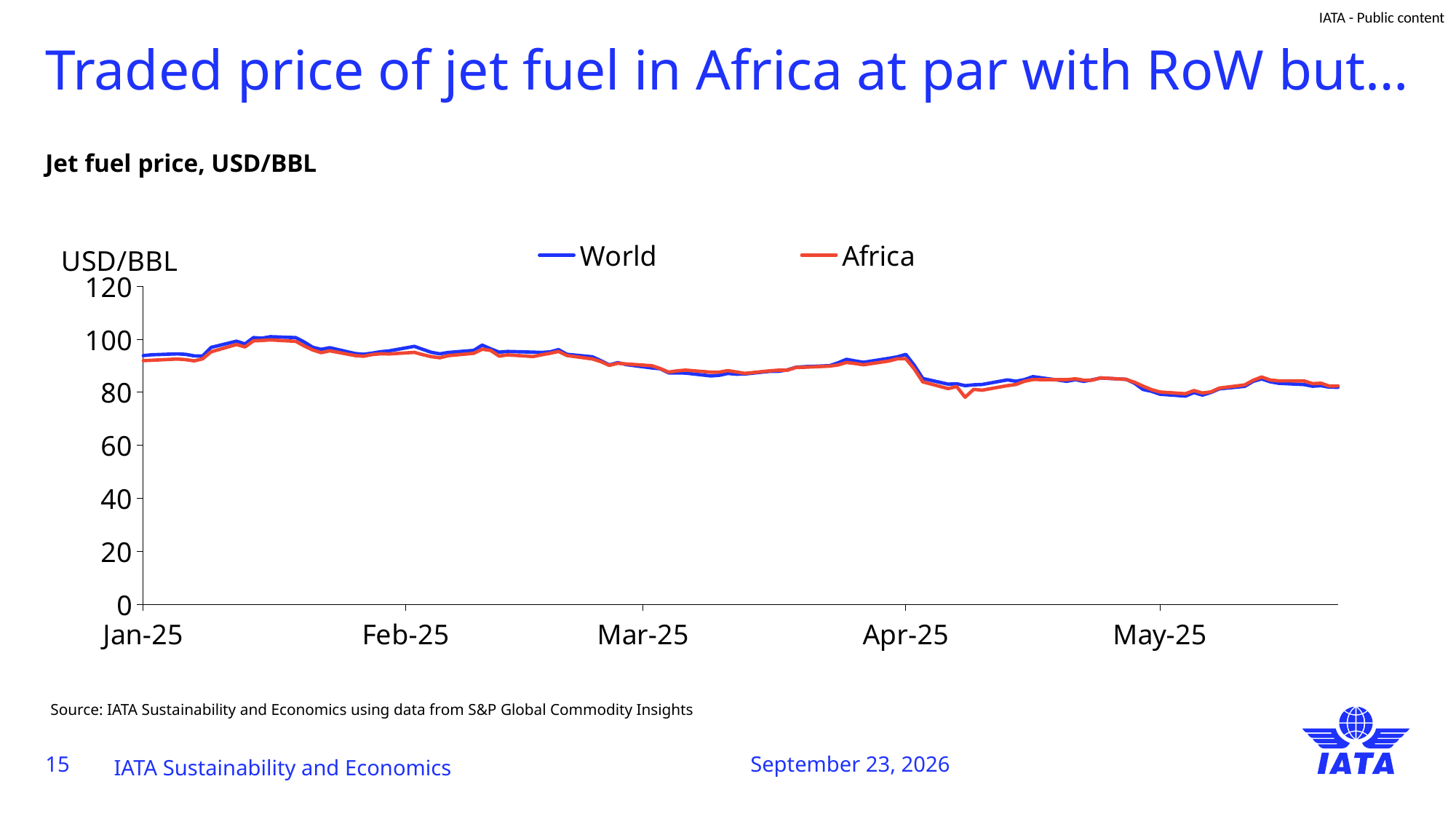
Is the World jet fuel price at Jan-25 greater or less than 80? greater What kind of chart is shown on the slide? Line chart Is the Africa jet fuel price at May-25 greater or less than 100? less Is the World jet fuel price at Mar-25 greater or less than 60? greater What is the highest value shown on the y axis? 120 How many series does the legend list? 2 Overall, do the jet fuel prices rise or fall from Jan-25 to May-25? Fall How many month labels are shown on the x axis? 5 What colour is the line for Africa? Red Which two series are shown in the legend? World and Africa